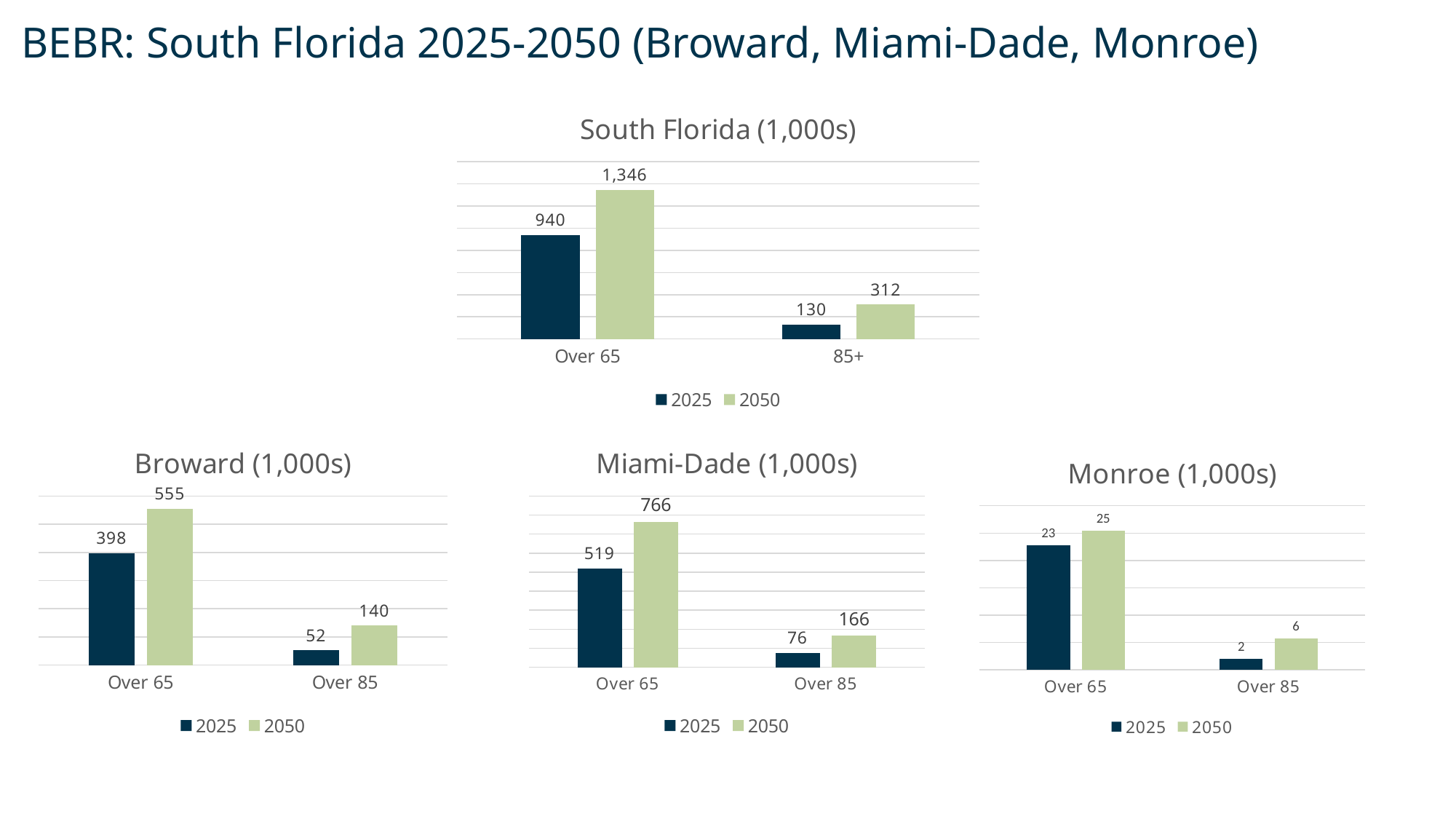
In the South Florida (1,000s) chart, what is the difference between the 2050 and 2025 values for Over 65? 406 In the South Florida (1,000s) chart, what is the 2025 value for 85+? 130 In the Miami-Dade (1,000s) chart, what is the 2025 value for Over 65? 519 In the Miami-Dade (1,000s) chart, which bar is the highest? 2050 Over 65 In the Monroe (1,000s) chart, which bar is the lowest? 2025 Over 85 In the Monroe (1,000s) chart, what is the 2050 value for Over 85? 6 How many series does the legend of the Broward (1,000s) chart list? 2 In the South Florida (1,000s) chart, what is the 2050 value for Over 65? 1,346 What kind of chart is the South Florida (1,000s) chart? Bar chart In the Miami-Dade (1,000s) chart, which is larger: the 2050 value for Over 85 or the 2025 value for Over 85? 2050 value for Over 85 In the Broward (1,000s) chart, what is the 2050 value for Over 85? 140 In the Broward (1,000s) chart, what is the difference between the 2050 and 2025 values for Over 65? 157